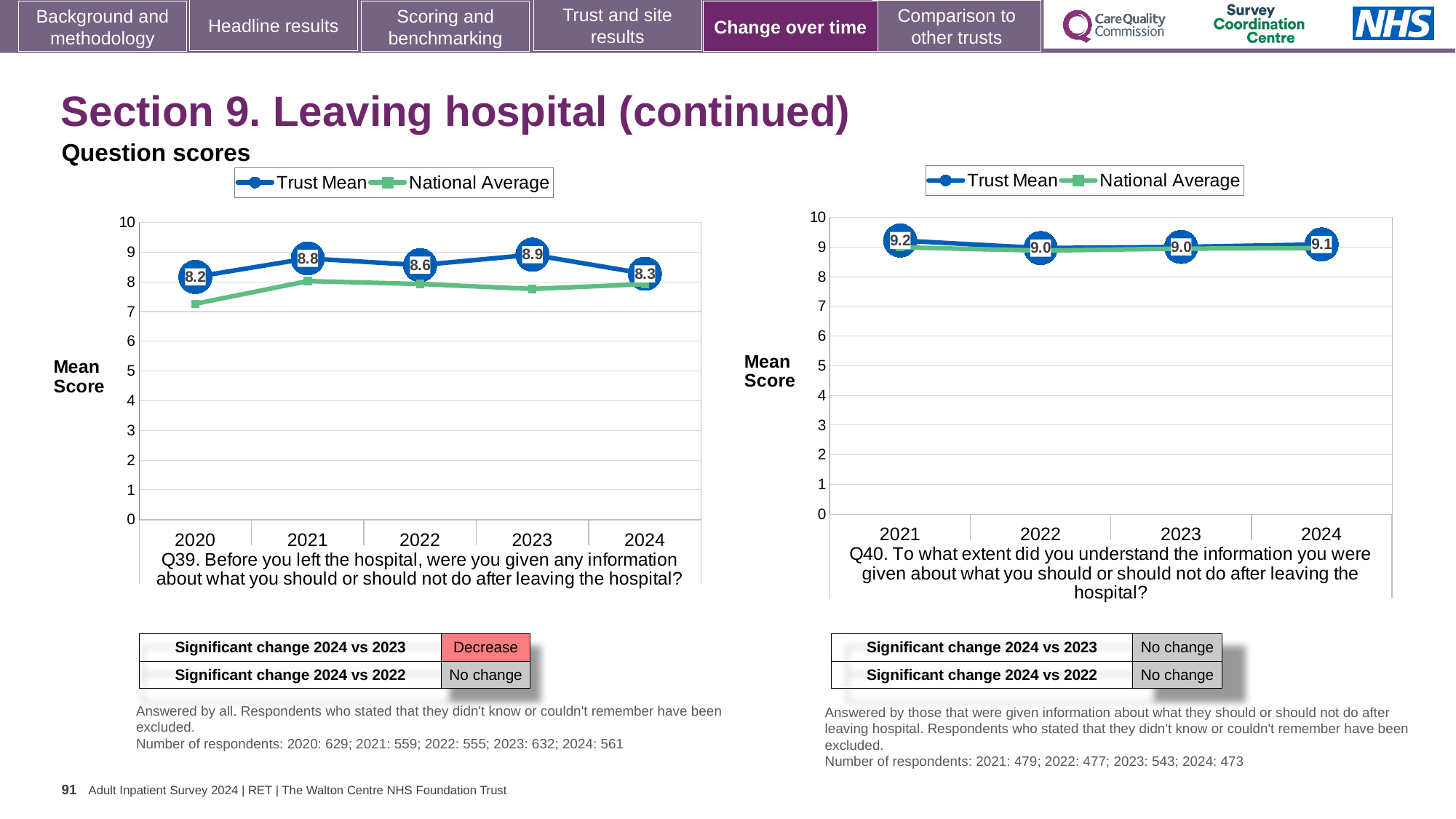
How many series does the legend of the Q40 chart on the right list? 2 How many years are plotted on the x axis of the Q39 chart on the left? 5 In the Q39 chart on the left, which year has the lowest Trust Mean score? 2020 In the Q39 chart on the left, which year has the highest Trust Mean score? 2023 In the Q40 chart on the right, what is the Trust Mean score for 2021? 9.2 In the Q40 chart on the right, what is the Trust Mean score for 2024? 9.1 In the Q39 chart on the left, what is the difference between the Trust Mean scores for 2023 and 2024? 0.6 In the Q39 chart on the left, is the National Average for 2020 greater or less than 8? less In the Q39 chart on the left, what is the Trust Mean score for 2021? 8.8 What type of chart is the Q39 chart on the left? Line chart In the Q40 chart on the right, is the Trust Mean score for 2021 larger or smaller than the score for 2022? larger In the Q39 chart on the left, what is the Trust Mean score for 2024? 8.3